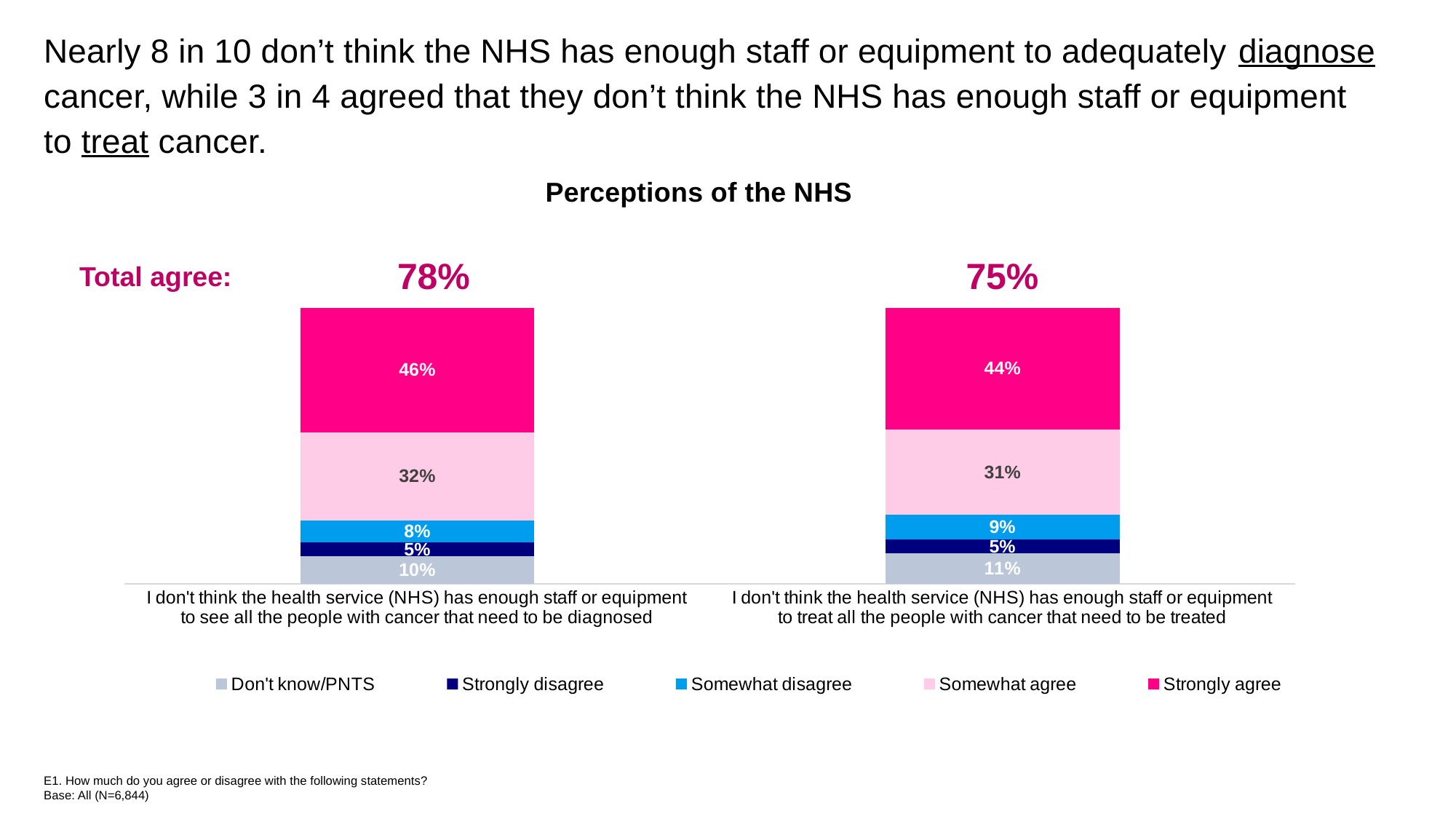
How many statements (categories) are plotted in the chart? 2 How many series does the legend list? 5 What is the Don't know/PNTS value for the statement about treating all the people with cancer? 11% What percentage somewhat agree that the NHS does not have enough staff or equipment to treat all the people with cancer that need to be treated? 31% What percentage strongly agree that the NHS does not have enough staff or equipment to see all the people with cancer that need to be diagnosed? 46% What is the Somewhat disagree value for the statement about diagnosing all the people with cancer? 8% What is the title of the chart? Perceptions of the NHS What is the total agree figure shown for the statement about diagnosing cancer? 78% What kind of chart is shown on the slide? Stacked bar chart What is the difference between the Strongly agree values for the diagnosing statement and the treating statement? 2% Which statement has the higher Strongly agree value: the one about diagnosing or the one about treating? Diagnosing Which series is the largest segment in both bars? Strongly agree